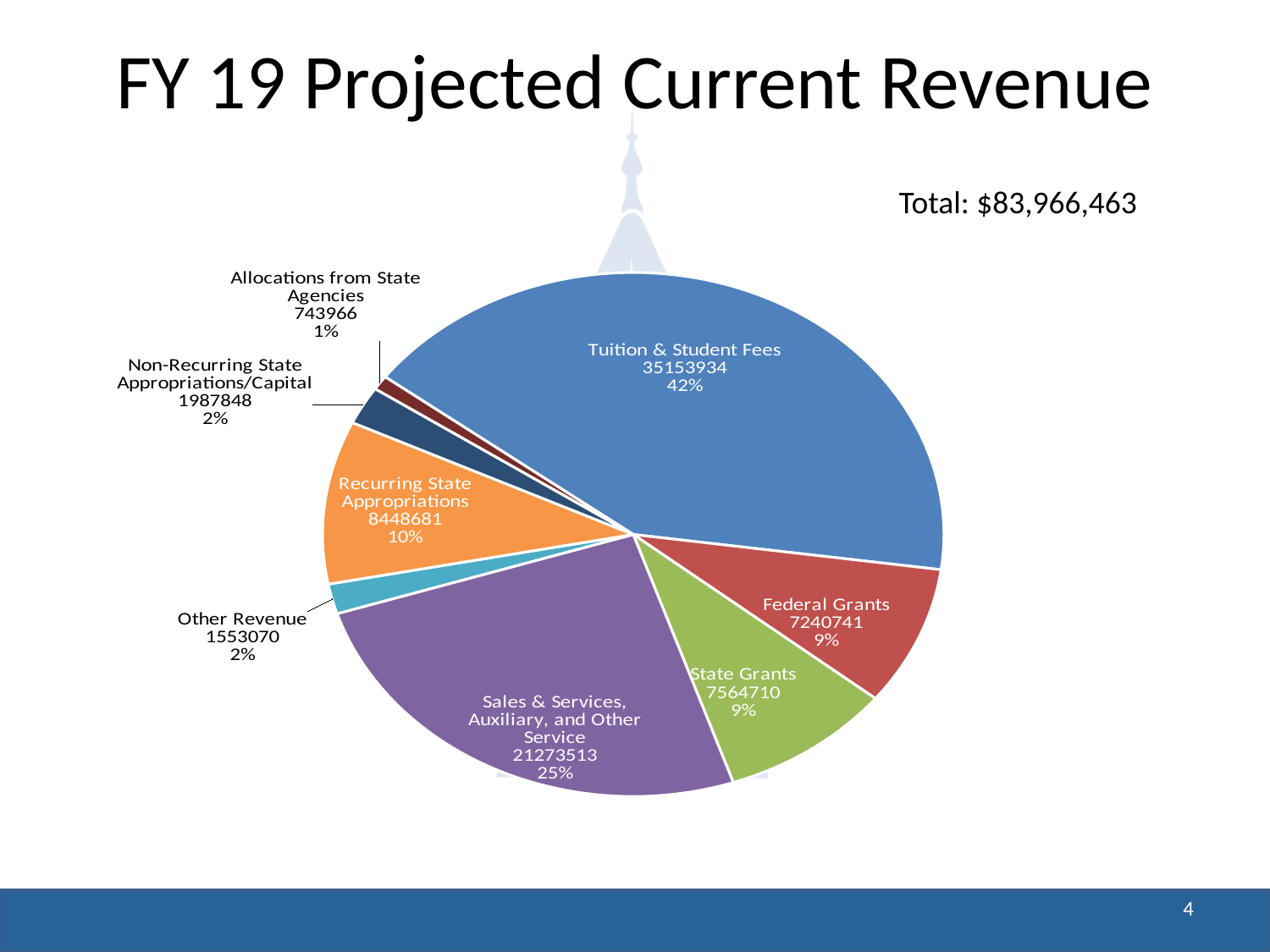
What total is stated on the slide for the projected current revenue? $83,966,463 What share of the pie does Recurring State Appropriations represent? 10% What type of chart is shown on the slide? pie chart Which is larger by value, State Grants or Federal Grants? State Grants Which category has the largest slice of the pie? Tuition & Student Fees What is the value for Tuition & Student Fees? 35153934 How many categories are shown in the pie chart? 8 Which category has the smallest slice of the pie? Allocations from State Agencies What is the value for Other Revenue? 1553070 What share of the pie does Sales & Services, Auxiliary, and Other Service represent? 25% What is the difference between the values for Tuition & Student Fees and Sales & Services, Auxiliary, and Other Service? 13880421 What is the value for Recurring State Appropriations? 8448681